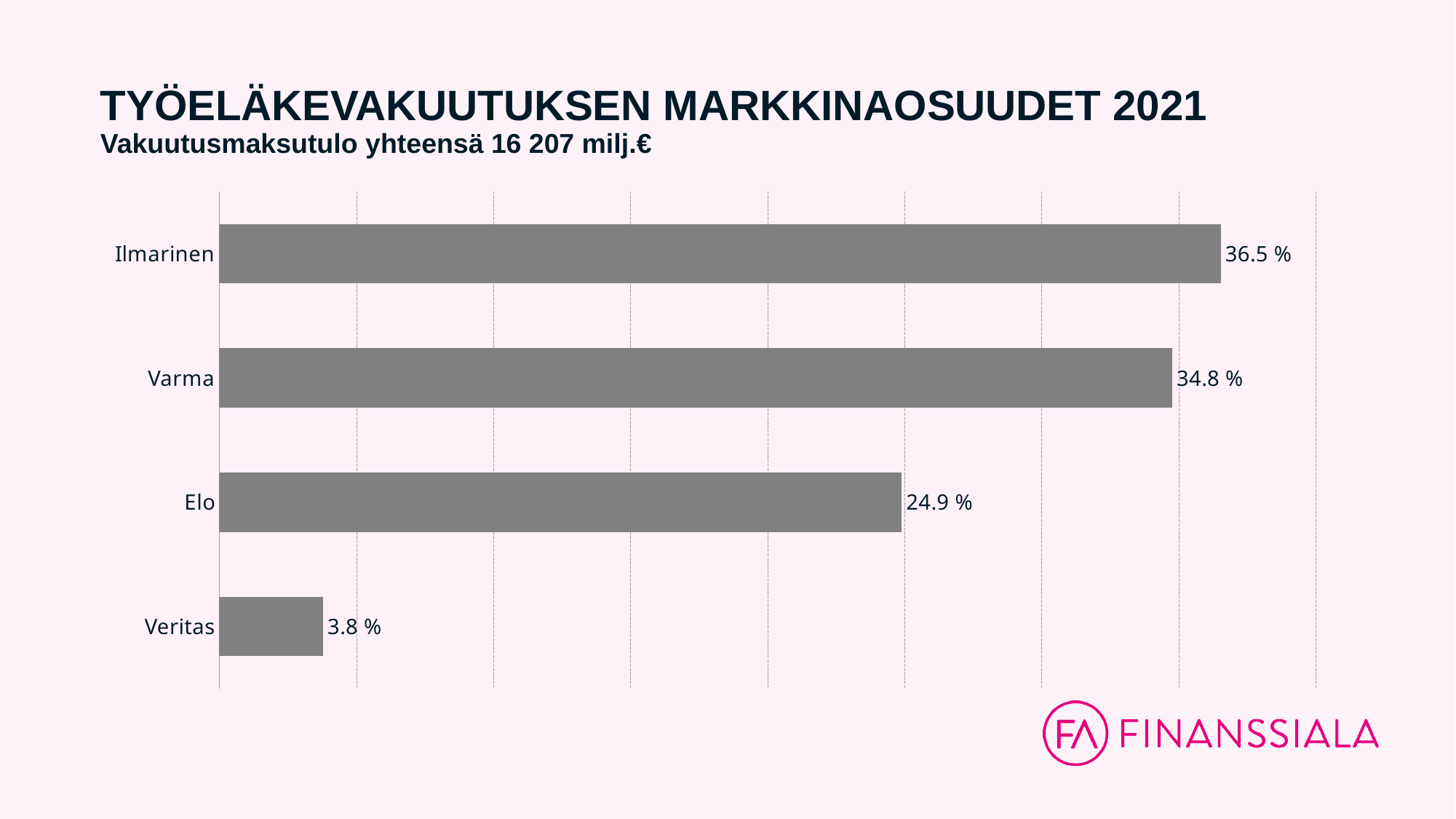
What is the difference in percentage points between Elo's and Veritas's market shares? 21.1 What is the market share shown for Veritas? 3.8 % What is the difference in percentage points between Ilmarinen's and Varma's market shares? 1.7 What total premium income (vakuutusmaksutulo yhteensä) is stated in the chart subtitle? 16 207 milj.€ Which company has the highest market share on the chart? Ilmarinen Which company has the lowest market share on the chart? Veritas Which has a larger market share, Elo or Veritas? Elo What is the market share shown for Elo? 24.9 % What is the market share shown for Ilmarinen? 36.5 % What type of chart is shown on the slide? Bar chart How many companies are shown on the chart? 4 What is the market share shown for Varma? 34.8 %